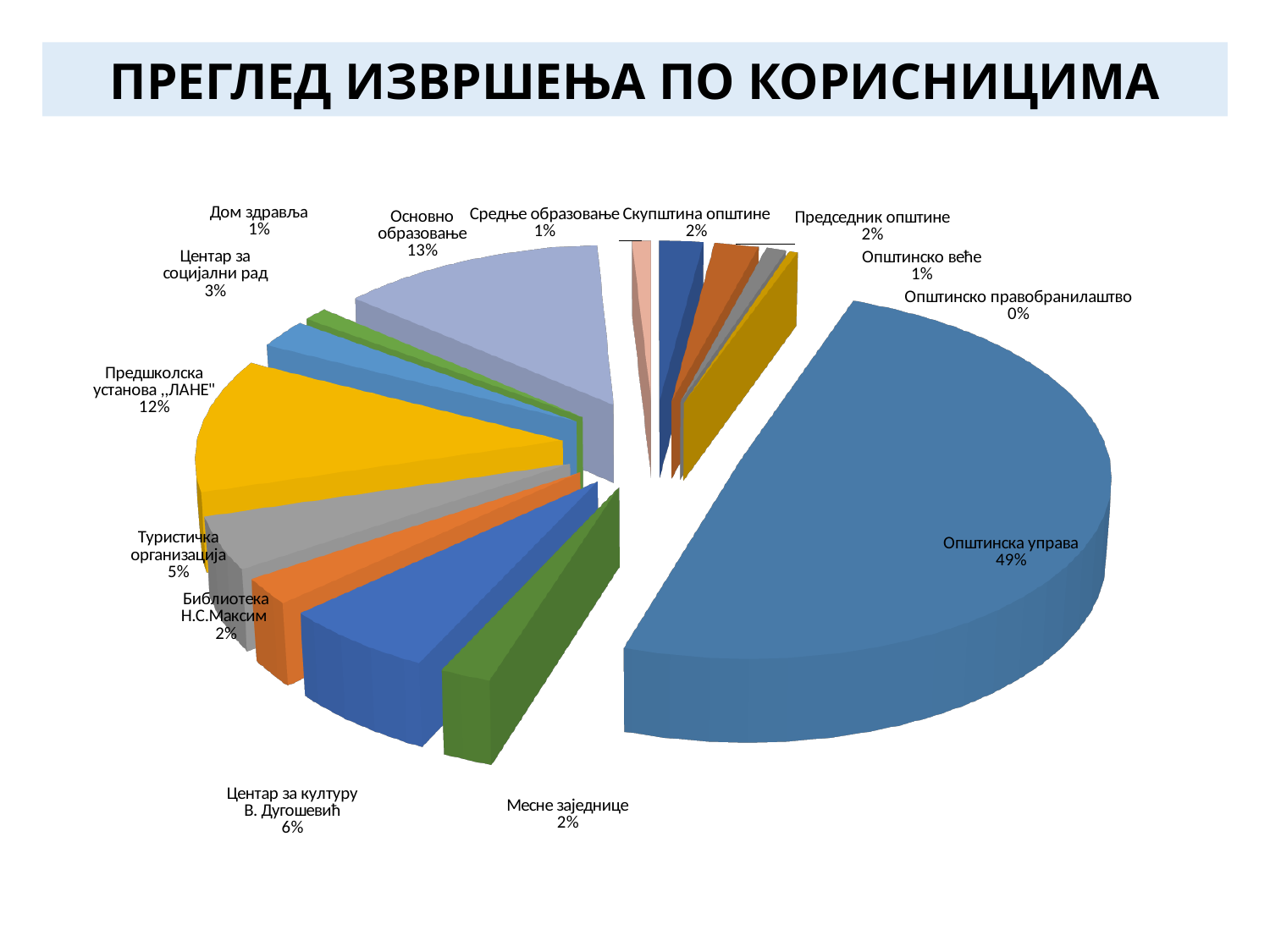
What percentage is shown for Туристичка организација? 5% Which category has the smallest share of the pie? Општинско правобранилаштво What percentage is shown for Центар за културу В. Дугошевић? 6% What percentage is shown for Предшколска установа ,,ЛАНЕ"? 12% How many categories are shown in the pie chart? 14 Which category has the largest share of the pie? Општинска управа What is the difference in percentage points between Општинска управа and Основно образовање? 36 What is the title of the chart slide? ПРЕГЛЕД ИЗВРШЕЊА ПО КОРИСНИЦИМА What percentage is shown for Основно образовање? 13% What share of the pie does Општинска управа have? 49% Which has a larger share, Центар за социјални рад or Туристичка организација? Туристичка организација What kind of chart is shown on the slide? pie chart